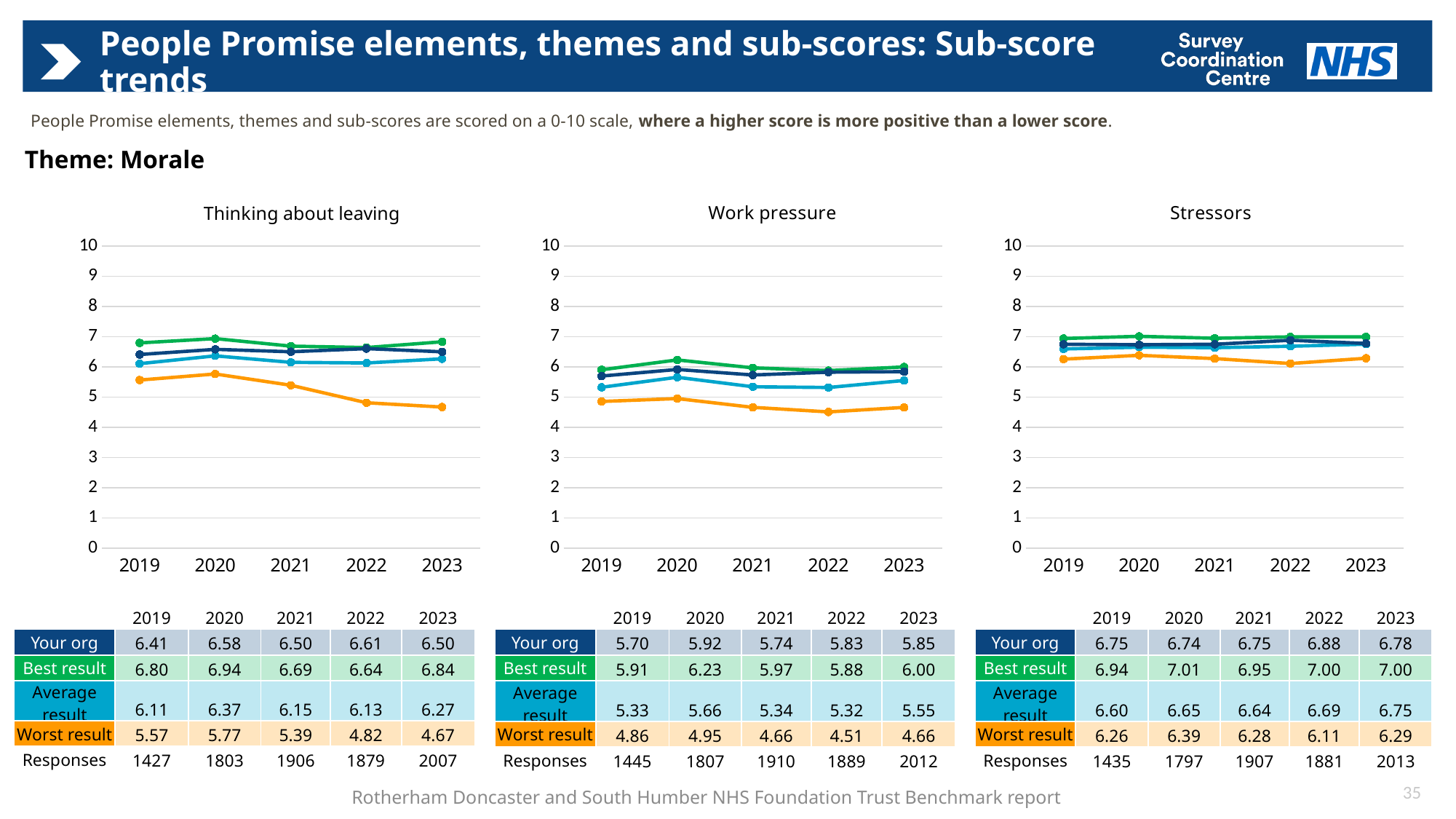
In the Stressors chart, what is the Best result score for 2020? 7.01 What kind of chart is used for the Work pressure sub-score? Line chart In the Work pressure chart, is the Your org value for 2019 greater or less than 6? less In the Thinking about leaving chart, what is the difference between the Best result and Your org scores in 2023? 0.34 How many series are plotted in the Stressors chart? 4 In the Work pressure chart, what is the Worst result score for 2022? 4.51 In the Thinking about leaving chart, what is the Your org score for 2023? 6.50 In the Thinking about leaving chart, which year has the lowest Worst result score? 2023 In the Thinking about leaving chart, does the Worst result line rise or fall from 2019 to 2023? Falls How many years are shown on the x axis of the Stressors chart? 5 In the Stressors chart, is the Your org score higher in 2021 or 2022? 2022 In the Work pressure chart, which year has the highest Best result score? 2020